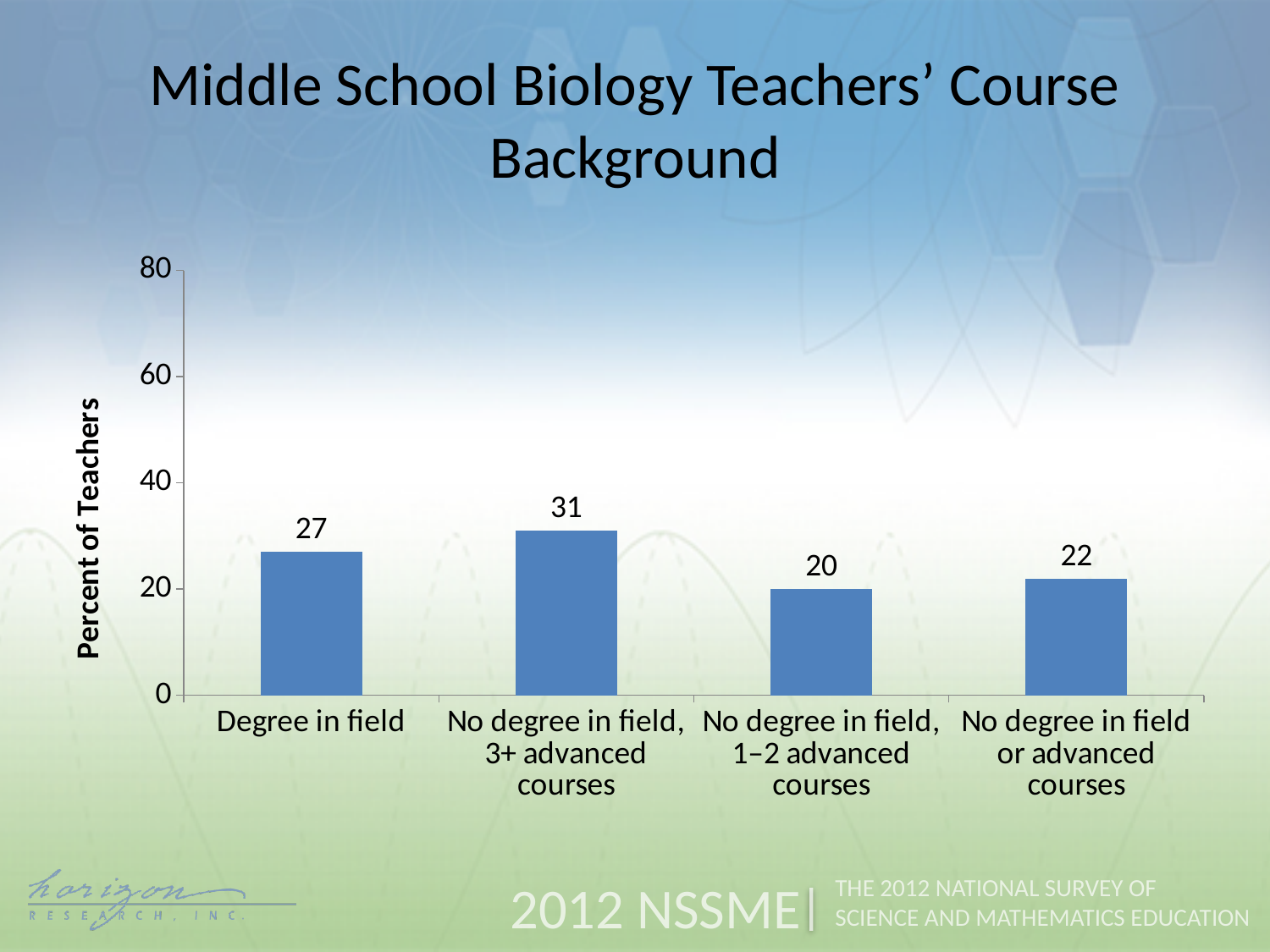
What is the difference between the values for 'No degree in field, 3+ advanced courses' and 'Degree in field'? 4 What is the value for 'No degree in field, 3+ advanced courses'? 31 What kind of chart is shown on the slide? bar chart What is the value for 'No degree in field or advanced courses'? 22 What is the label of the vertical axis? Percent of Teachers Which category has the highest percent of teachers? No degree in field, 3+ advanced courses Which category has the lowest percent of teachers? No degree in field, 1–2 advanced courses Is the value for 'No degree in field, 3+ advanced courses' greater or less than 40? less Which is larger: the value for 'Degree in field' or for 'No degree in field or advanced courses'? Degree in field What is the value for 'No degree in field, 1–2 advanced courses'? 20 How many categories are shown on the x axis? 4 What percent of teachers have a degree in field? 27